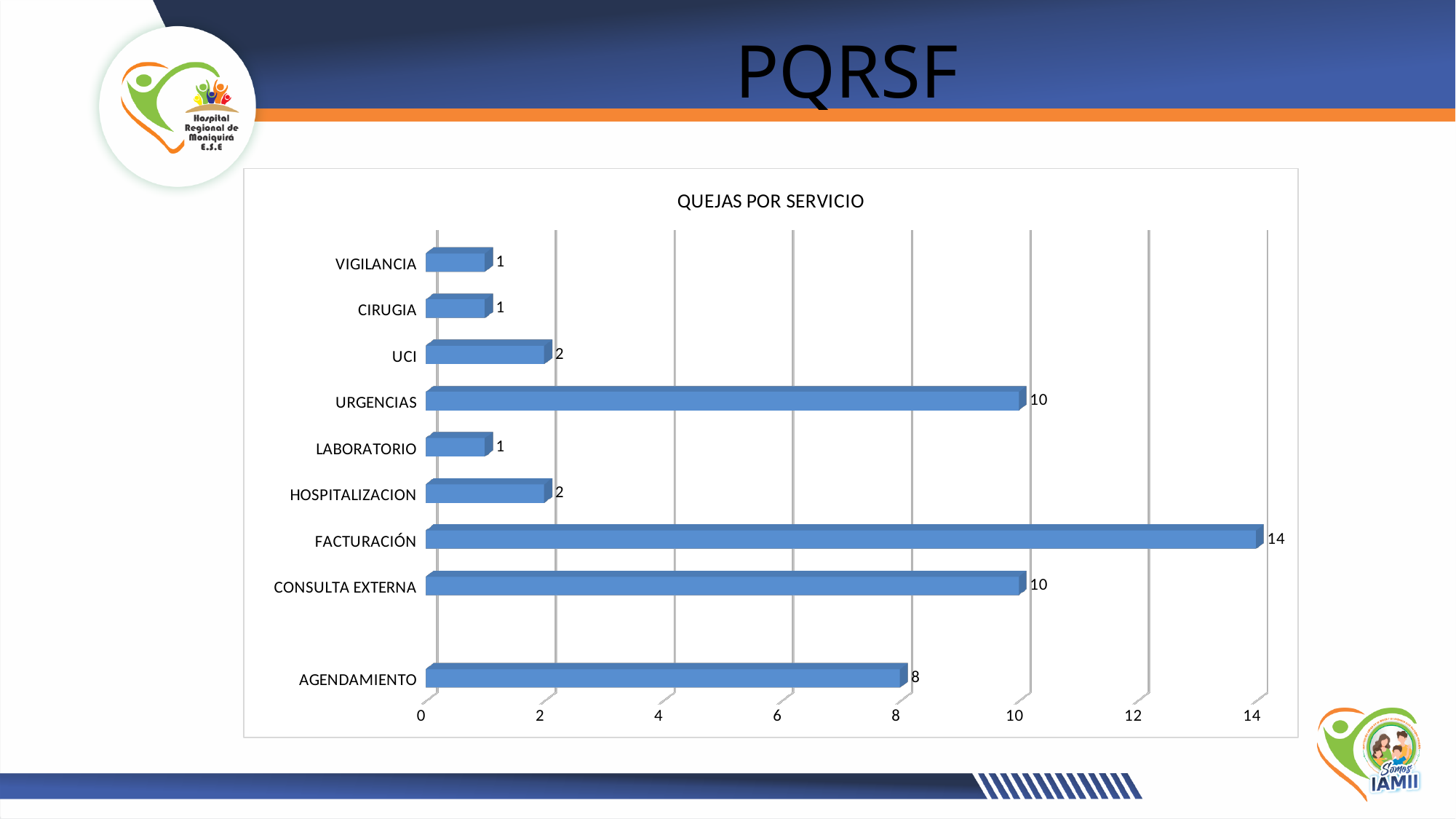
What is the title of the chart? QUEJAS POR SERVICIO What is the value for AGENDAMIENTO? 8 How many categories are shown in the chart? 9 What kind of chart is shown on the slide? bar chart What is the difference between the values for FACTURACIÓN and CONSULTA EXTERNA? 4 What is the value for FACTURACIÓN? 14 Is the value for CONSULTA EXTERNA greater or less than 6? greater Which is larger, the value for URGENCIAS or the value for AGENDAMIENTO? URGENCIAS What is the value for URGENCIAS? 10 What is the difference between the values for AGENDAMIENTO and HOSPITALIZACION? 6 Which category has the highest value? FACTURACIÓN What is the value for UCI? 2